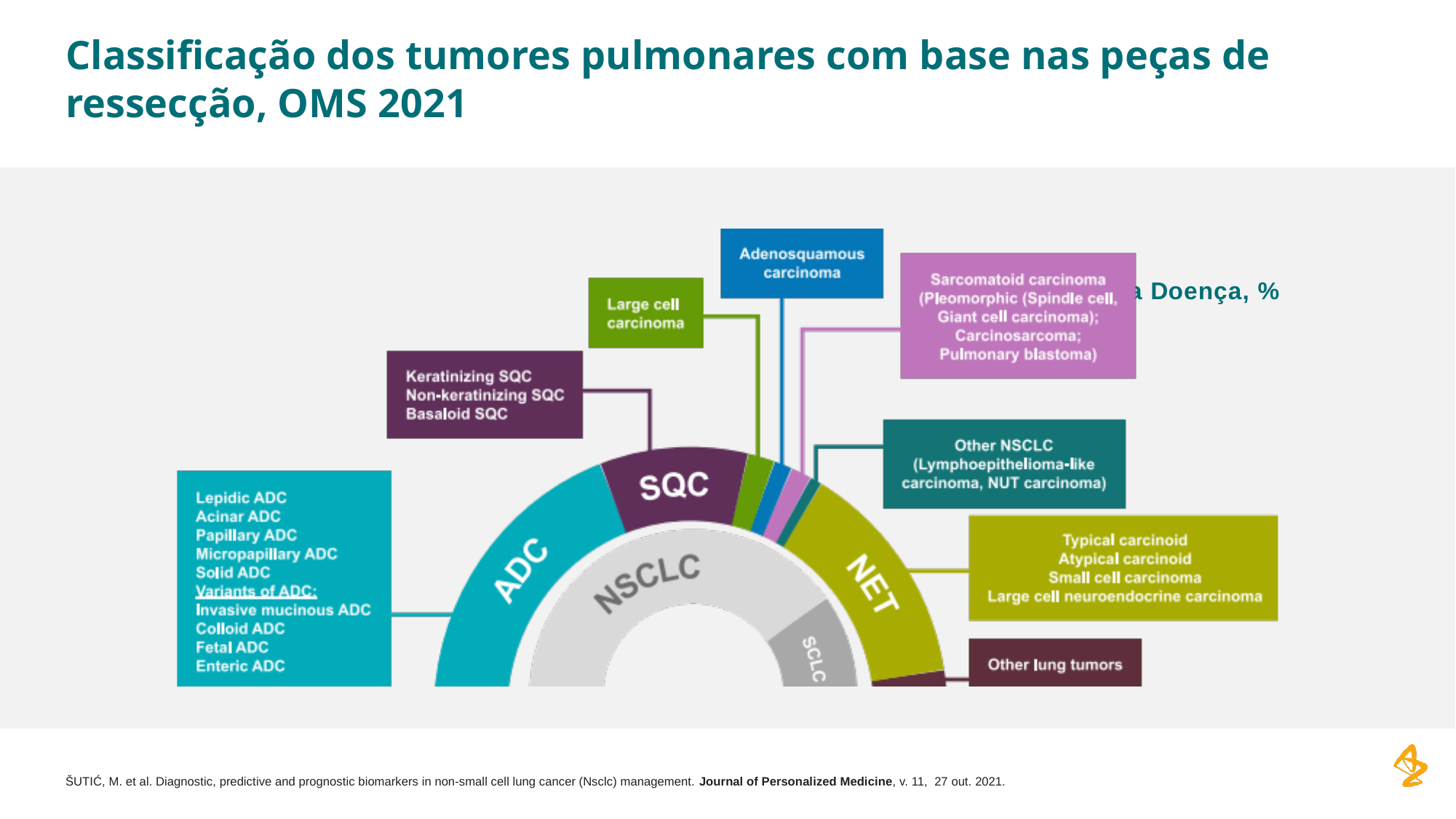
Which segment is larger in the semicircular diagram, ADC or SQC? ADC Which segment is larger in the semicircular diagram, SQC or Large cell carcinoma? SQC Which segment of the semicircular diagram is labelled with the box listing Typical carcinoid, Atypical carcinoid, Small cell carcinoma and Large cell neuroendocrine carcinoma? NET Which segment is larger in the semicircular diagram, ADC or NET? ADC Which segment of the semicircular diagram is the largest? ADC What two categories are shown in the inner ring of the semicircular diagram? NSCLC and SCLC How many labelled segments make up the outer ring of the semicircular diagram? 8